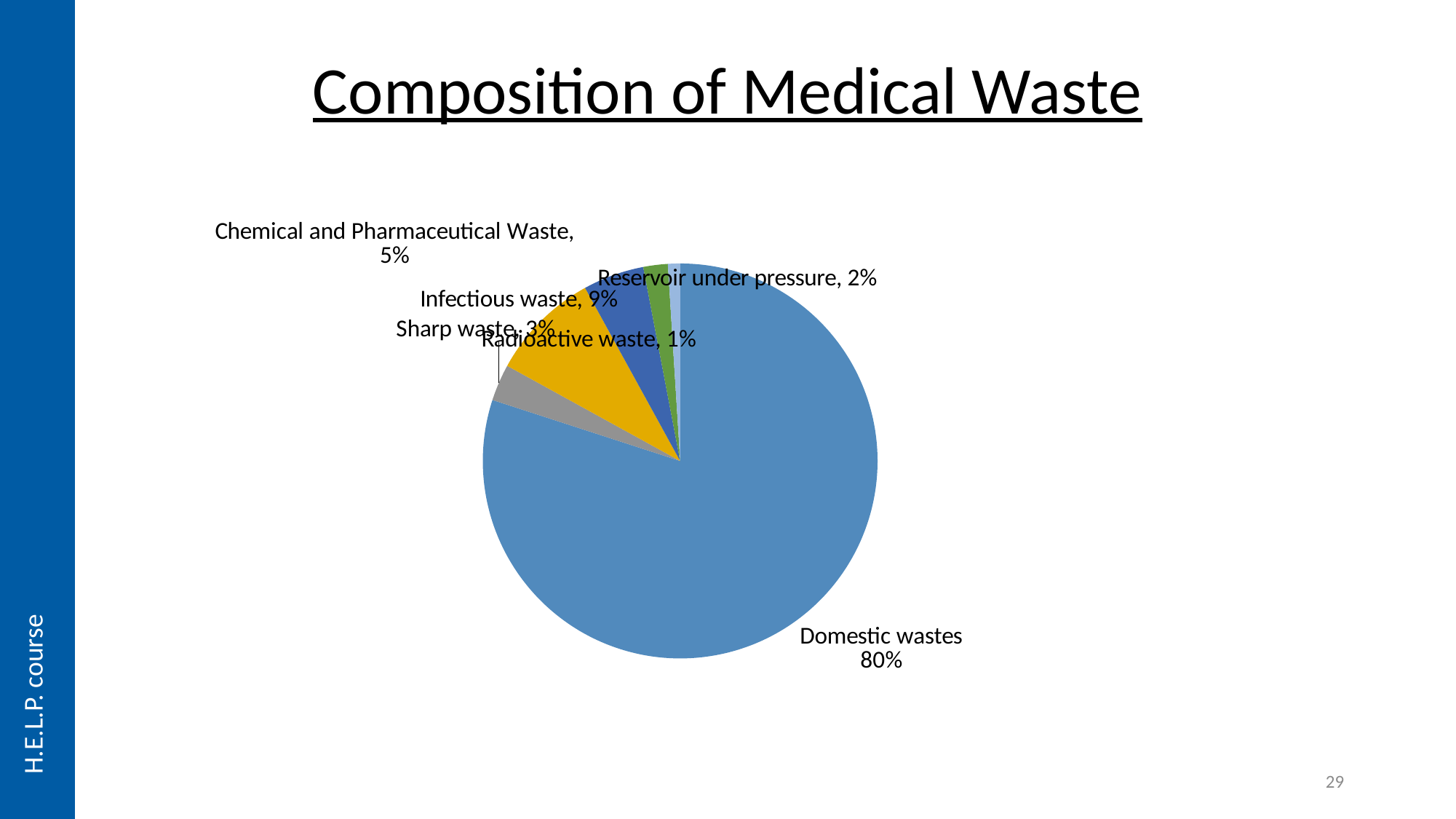
What percentage is shown for Sharp waste? 3% Which category has the smallest share of the pie? Radioactive waste What is the title of the chart? Composition of Medical Waste What percentage is shown for Chemical and Pharmaceutical Waste? 5% What kind of chart is shown on the slide? Pie chart How many categories are shown in the pie chart? 6 Which is larger, the share for Chemical and Pharmaceutical Waste or the share for Reservoir under pressure? Chemical and Pharmaceutical Waste What share of medical waste is Domestic wastes? 80% What percentage of medical waste is Infectious waste? 9% What is the difference in percentage points between Infectious waste and Sharp waste? 6 What percentage is shown for Reservoir under pressure? 2% Which category has the largest share of the pie? Domestic wastes